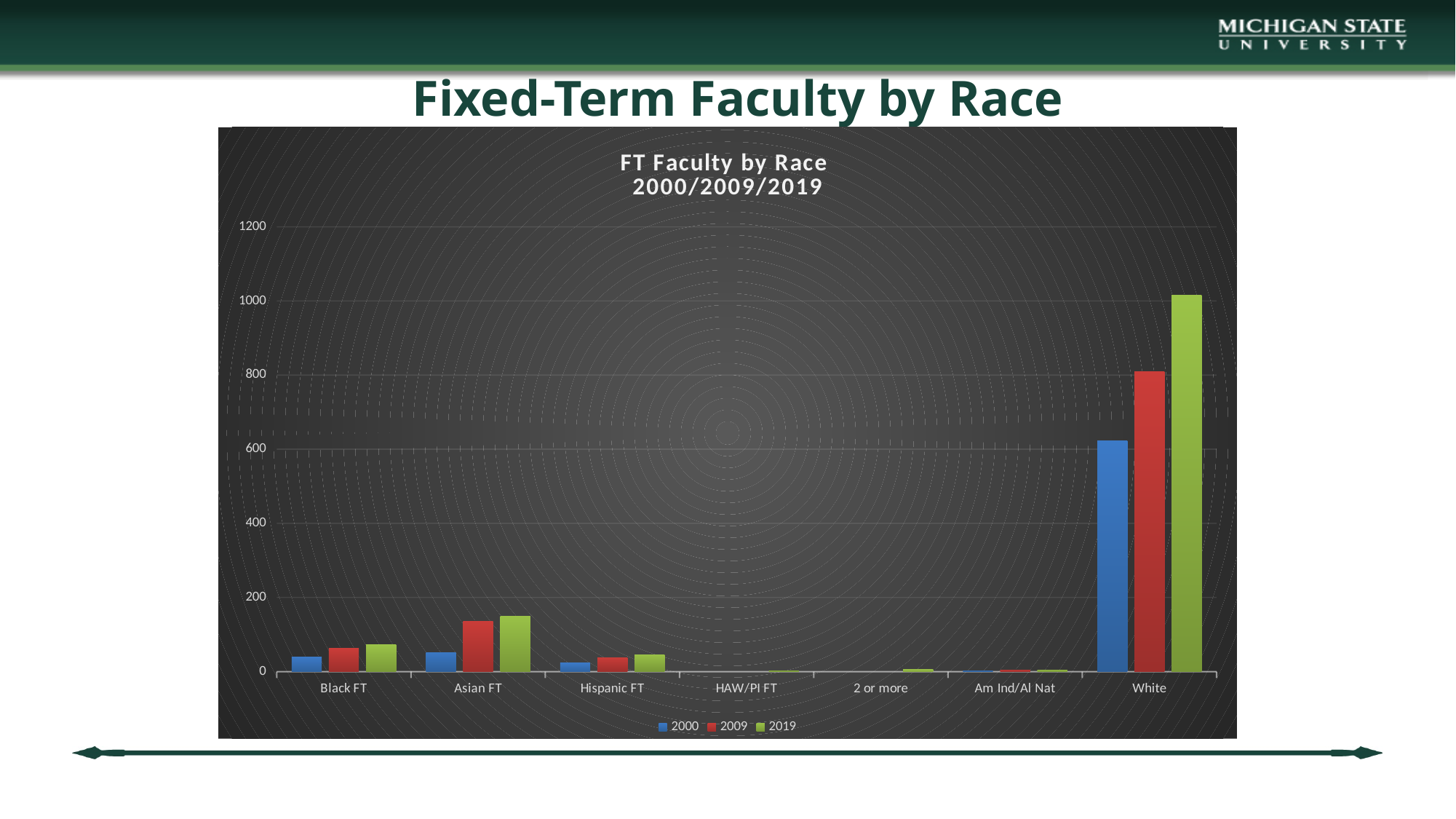
What kind of chart is shown on the slide? bar chart Which category has the highest value for the 2019 series? White Is the value for Asian FT in 2019 greater or less than 200? less What is the title of the chart? FT Faculty by Race 2000/2009/2019 Do the values for White rise or fall from 2000 to 2019? rise How many race categories are shown on the x axis? 7 Which is larger for 2019: Asian FT or Black FT? Asian FT How many series does the legend list? 3 Is the value for White in 2000 greater or less than 400? greater Is the value for White in 2019 greater or less than 800? greater Which category has the highest value for the 2000 series? White